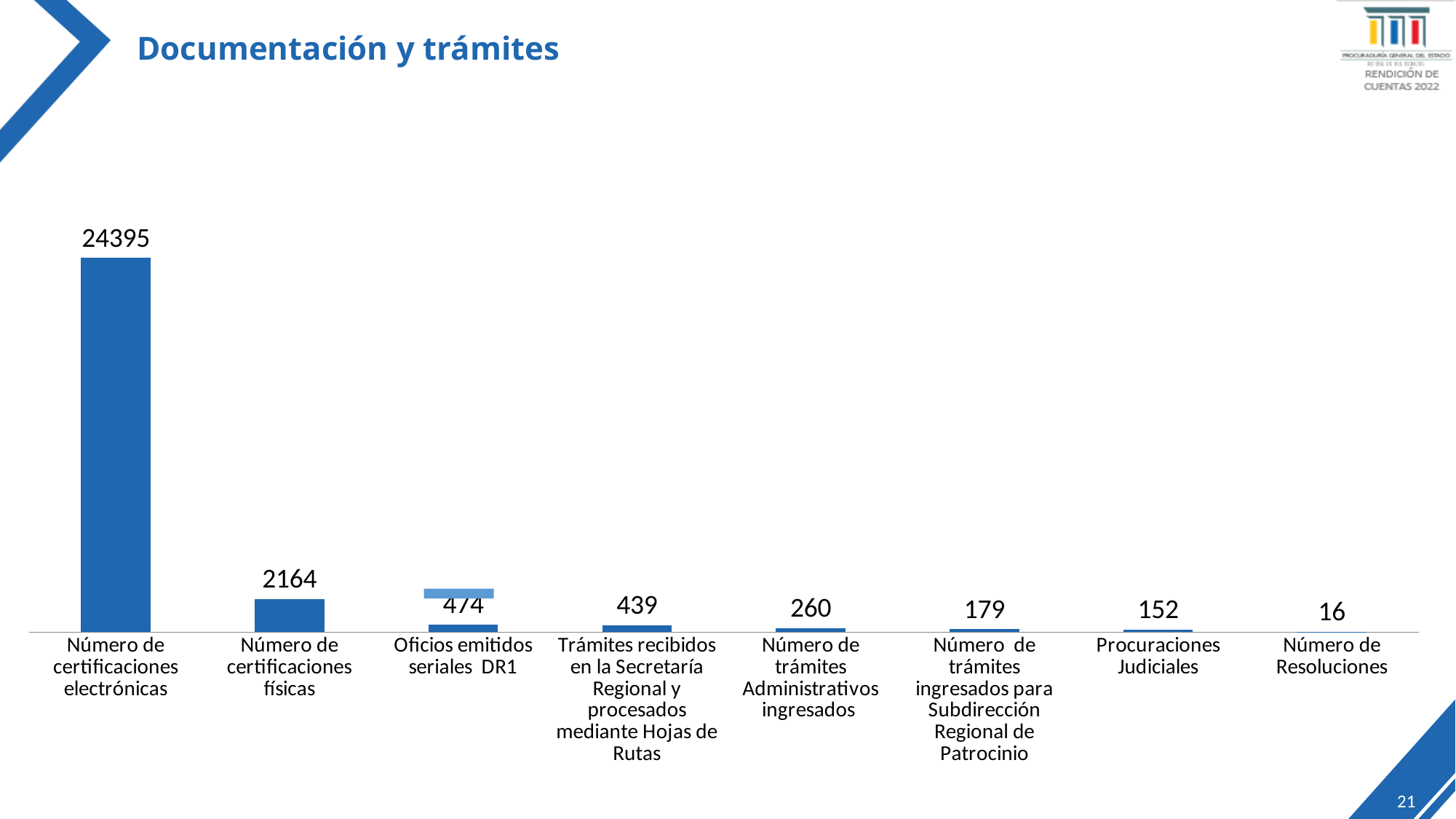
What is the value for Trámites recibidos en la Secretaría Regional y procesados mediante Hojas de Rutas? 439 What is the difference between Número de certificaciones electrónicas and Número de certificaciones físicas? 22231 Which is larger: Número de trámites ingresados para Subdirección Regional de Patrocinio or Procuraciones Judiciales? Número de trámites ingresados para Subdirección Regional de Patrocinio What is the value for Número de trámites Administrativos ingresados? 260 Which category has the lowest value? Número de Resoluciones What is the title of the slide containing the chart? Documentación y trámites What is the value for Número de certificaciones físicas? 2164 Which category has the highest value? Número de certificaciones electrónicas What kind of chart is shown on the slide? bar chart How many categories are plotted in the chart? 8 What is the value for Procuraciones Judiciales? 152 What is the value for Número de certificaciones electrónicas? 24395